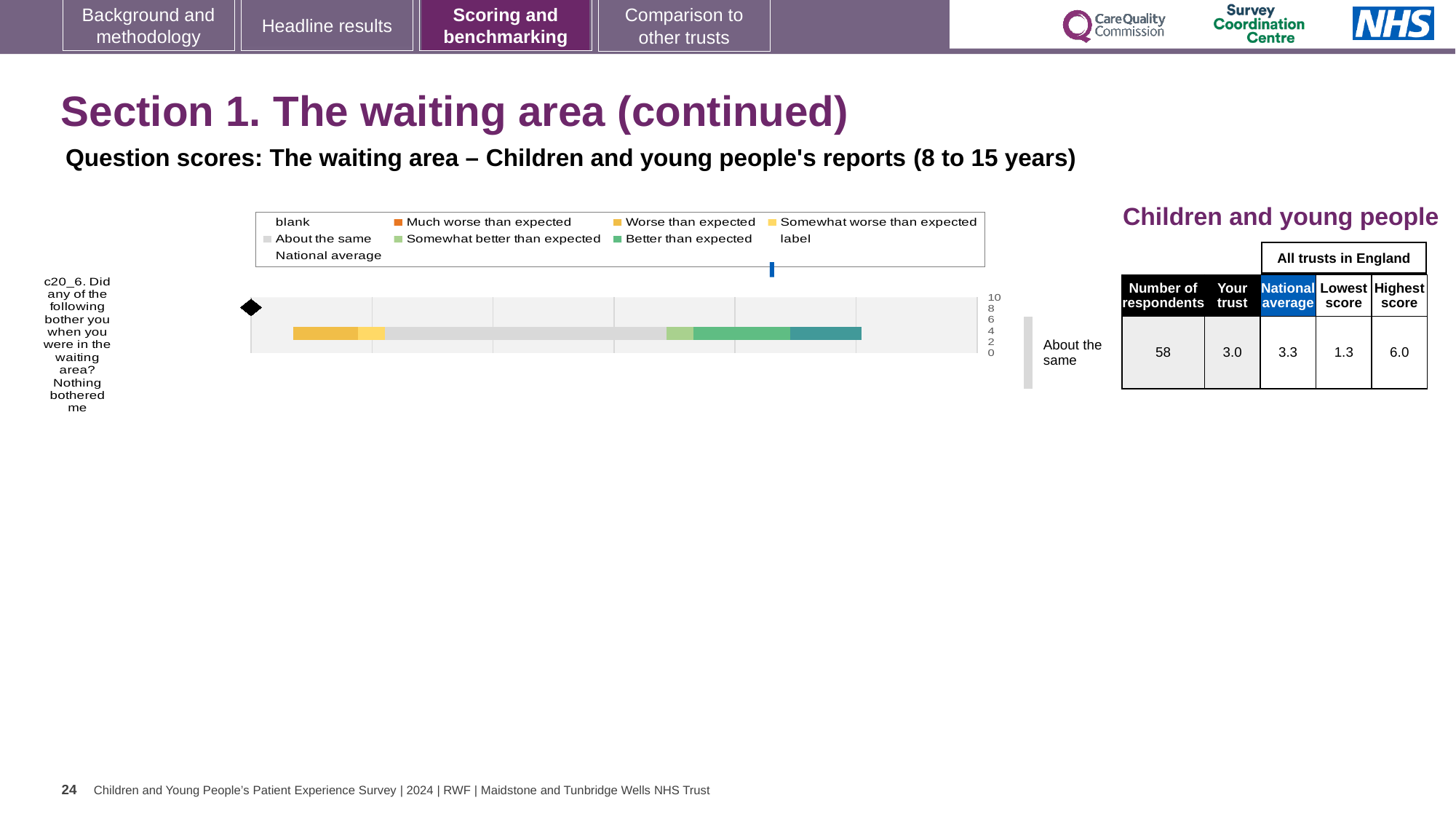
What is the highest score across all trusts in England for question c20_6? 6.0 What benchmark category is the trust's result for question c20_6 placed in? About the same Which is larger for question c20_6: the trust's score or the national average? National average What kind of chart is used to show the benchmarking result for question c20_6? Bar chart What is the difference between the highest score (6.0) and the lowest score (1.3) for question c20_6? 4.7 Is the trust's score for question c20_6 greater or less than 5? less How many respondents answered question c20_6? 58 What is the national average score for question c20_6? 3.3 How many survey questions are plotted on this chart? 1 What is the lowest score across all trusts in England for question c20_6? 1.3 What is the difference between the national average (3.3) and the trust's score (3.0) for question c20_6? 0.3 What is the 'Your trust' score for question c20_6 (Nothing bothered me in the waiting area)? 3.0